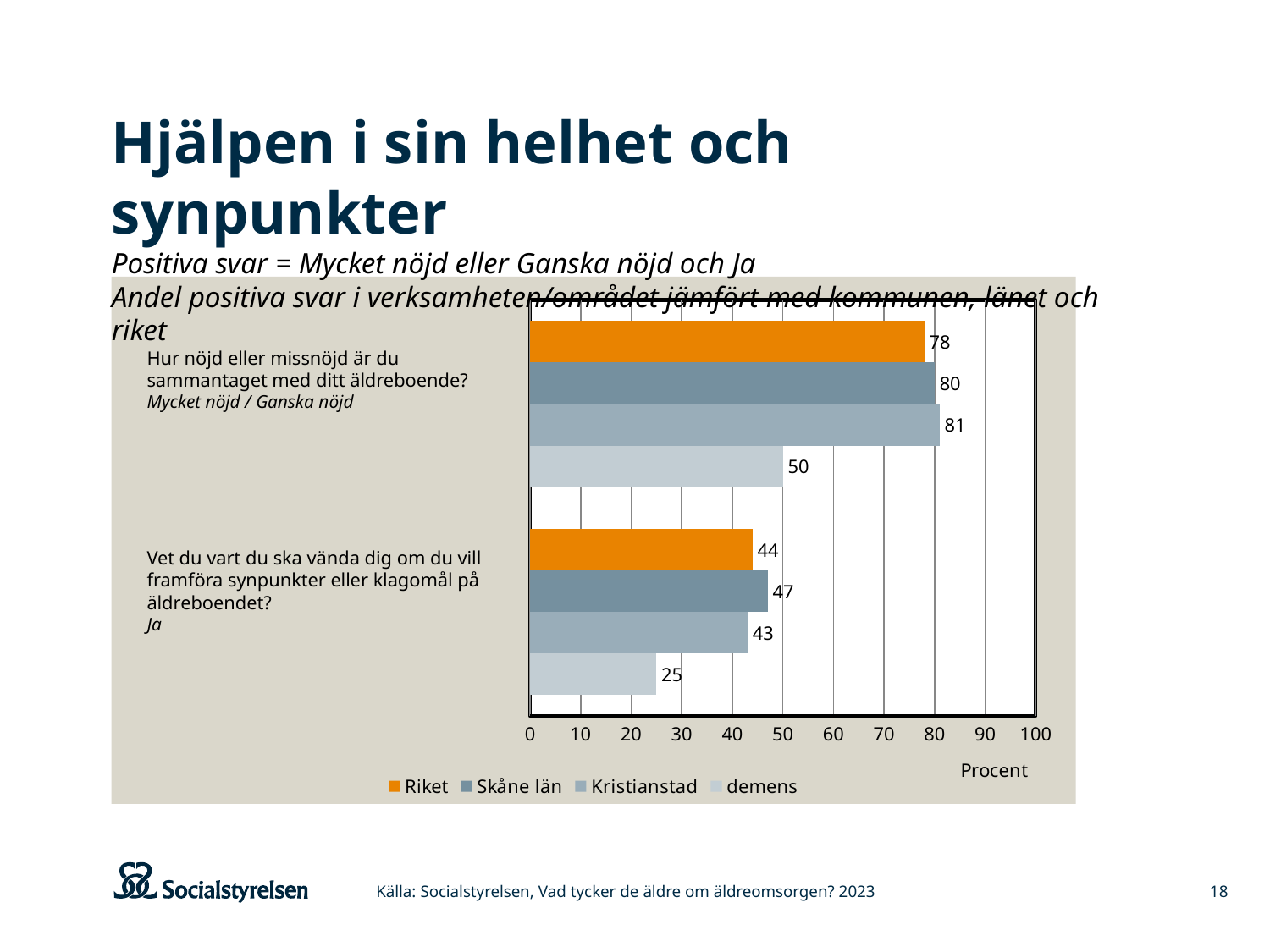
What is the value for Riket on the question about how satisfied you are overall with your äldreboende (Mycket nöjd / Ganska nöjd)? 78 What is the value for Skåne län on the question about whether you know where to turn to give synpunkter or klagomål? 47 Which is larger: the Riket value or the Kristianstad value on the question about knowing where to turn with synpunkter or klagomål? Riket What is the value for demens on the question about whether you know where to turn to give synpunkter or klagomål? 25 What is the difference between the Riket value and the demens value on the question about knowing where to turn with synpunkter or klagomål? 19 Which series has the lowest value on the question about overall satisfaction with the äldreboende? demens What is the difference between the Kristianstad value and the demens value on the question about overall satisfaction with the äldreboende? 31 How many series does the legend list? 4 What is the value for Kristianstad on the question about how satisfied you are overall with your äldreboende? 81 What kind of chart is shown on the slide? bar chart Which series has the highest value on the question about knowing where to turn with synpunkter or klagomål? Skåne län What unit label is shown under the x axis of the chart? Procent